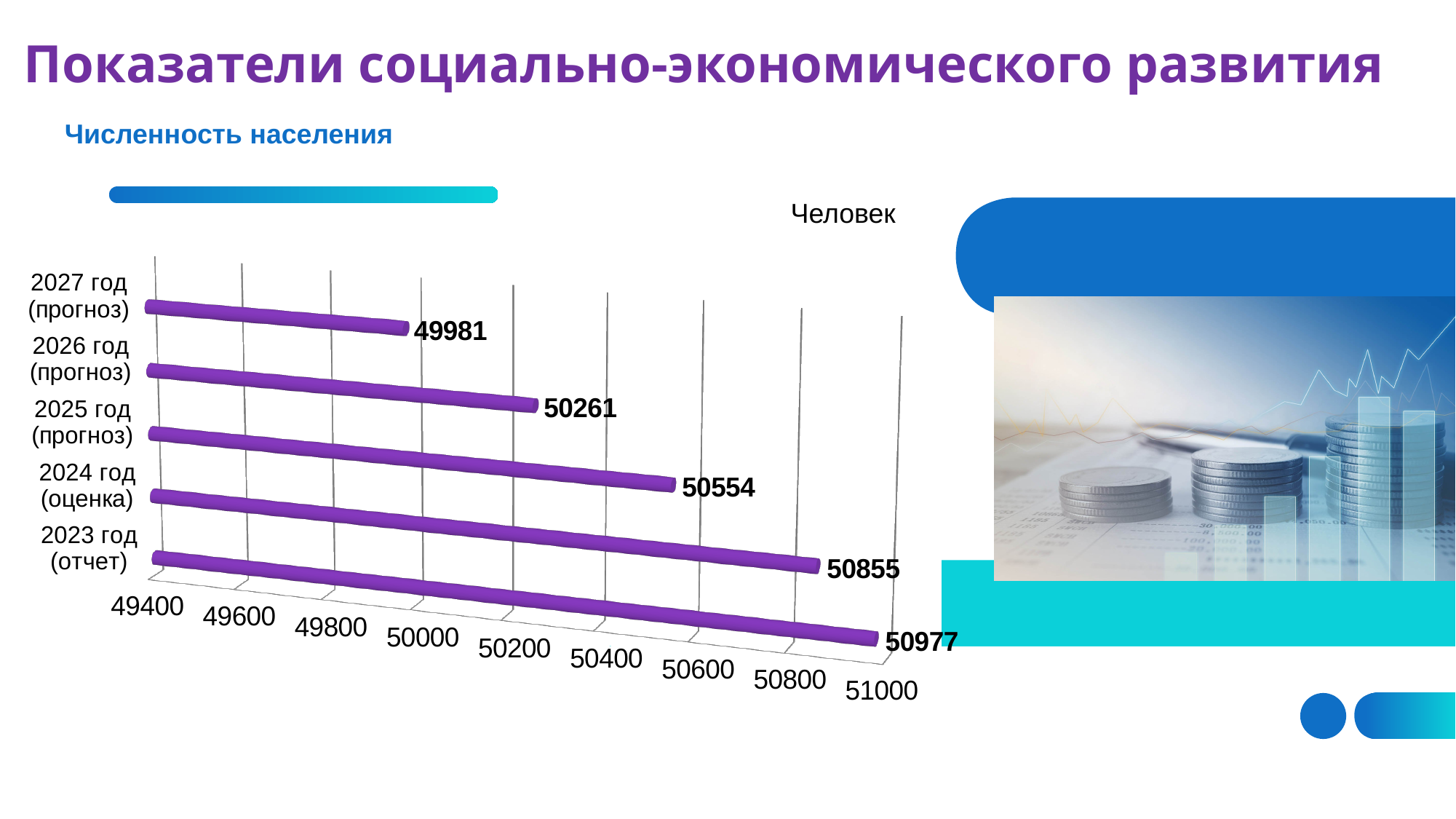
What is the difference between the population values for 2024 год (оценка) and 2025 год (прогноз)? 301 What is the population value shown for 2027 год (прогноз)? 49981 What unit of measurement is indicated for the chart values? Человек Which year has the lowest population value on the chart? 2027 год (прогноз) How many years (categories) are shown on the chart? 5 What is the difference between the population values for 2023 год (отчет) and 2027 год (прогноз)? 996 Which year has the highest population value on the chart? 2023 год (отчет) What is the population value shown for 2023 год (отчет)? 50977 What kind of chart is used to show the population figures? bar chart What is the population value shown for 2025 год (прогноз)? 50554 Which is larger, the population value for 2026 год (прогноз) or for 2024 год (оценка)? 2024 год (оценка) Is the value for 2027 год (прогноз) greater or less than 50000? less